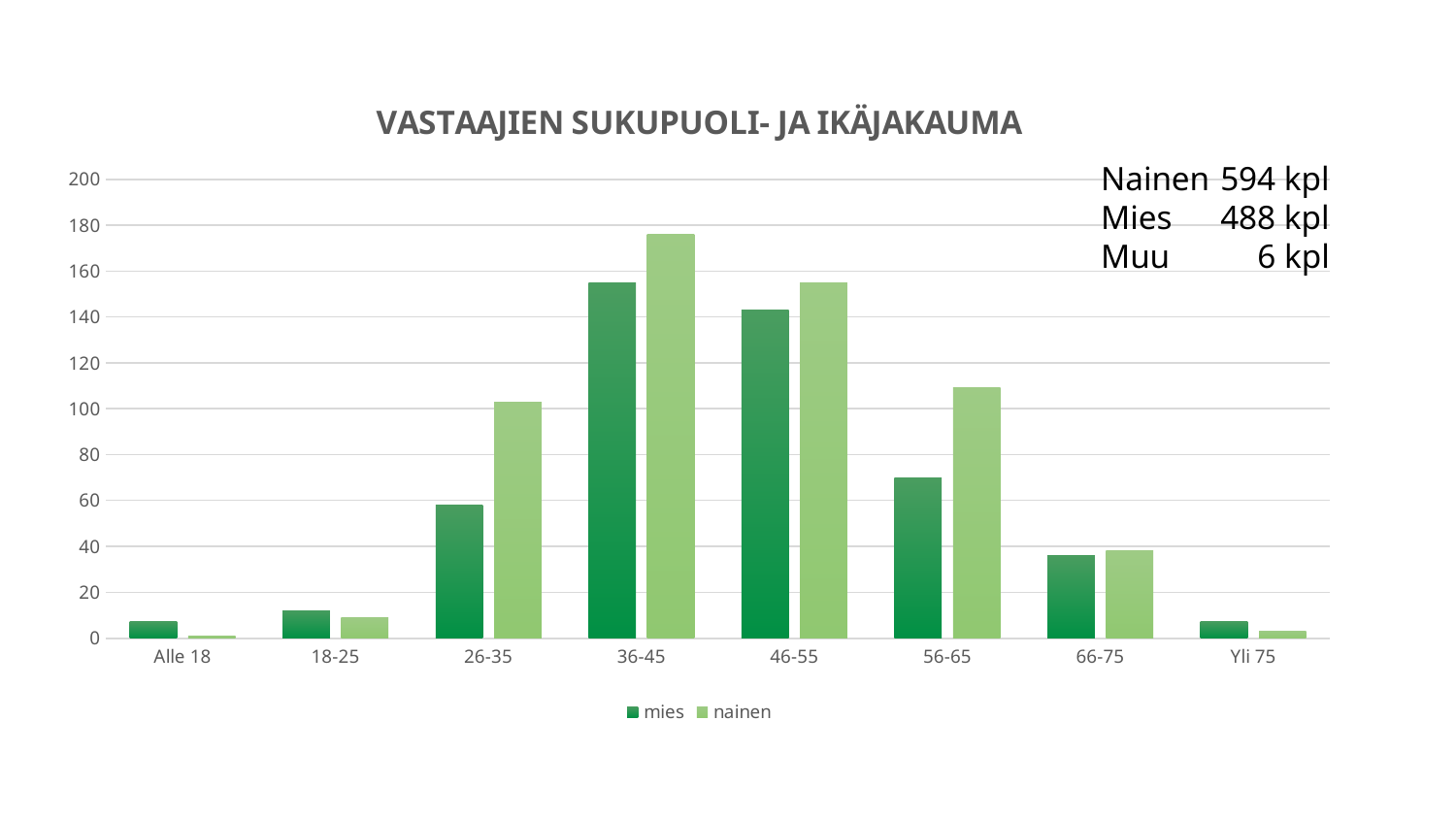
According to the text on the slide, how many respondents were Nainen? 594 kpl In the 26-35 category, which series has the larger value, mies or nainen? nainen How many age categories are shown on the x axis? 8 Which age category has the highest value for mies? 36-45 Is the value for mies in the 36-45 category greater or less than 140? greater Which age category has the highest value for nainen? 36-45 How many series does the legend list? 2 What is the title of the chart? VASTAAJIEN SUKUPUOLI- JA IKÄJAKAUMA Is the value for mies in the 56-65 category greater or less than 80? less Is the value for nainen in the 36-45 category greater or less than 160? greater What kind of chart is shown on the slide? bar chart Which age category has the lowest value for nainen? Alle 18